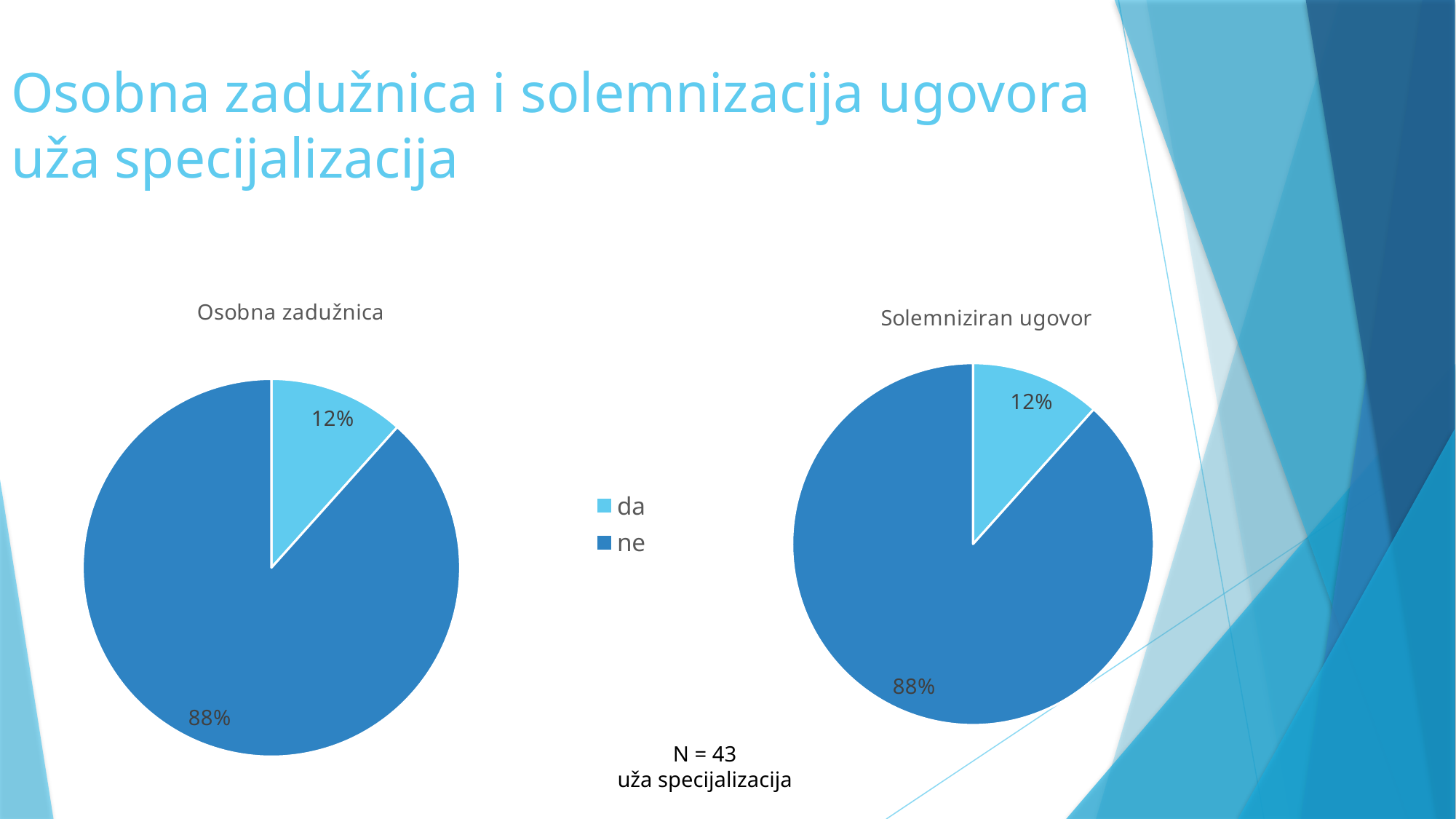
In the 'Osobna zadužnica' chart, what share of the pie is 'ne'? 88% In the 'Solemniziran ugovor' chart, which is larger, 'da' or 'ne'? ne In the 'Solemniziran ugovor' chart, what share of the pie is 'ne'? 88% In the 'Osobna zadužnica' chart, what is the difference between the 'ne' and 'da' shares? 76% In the 'Osobna zadužnica' chart, what share of the pie is 'da'? 12% In the 'Solemniziran ugovor' chart, which slice is the smallest? da What is the title of the pie chart on the right side of the slide? Solemniziran ugovor What kind of chart is the 'Osobna zadužnica' chart? Pie chart In the 'Osobna zadužnica' chart, which slice is the largest? ne How many entries does the shared legend list? 2 How many slices does the 'Solemniziran ugovor' pie chart have? 2